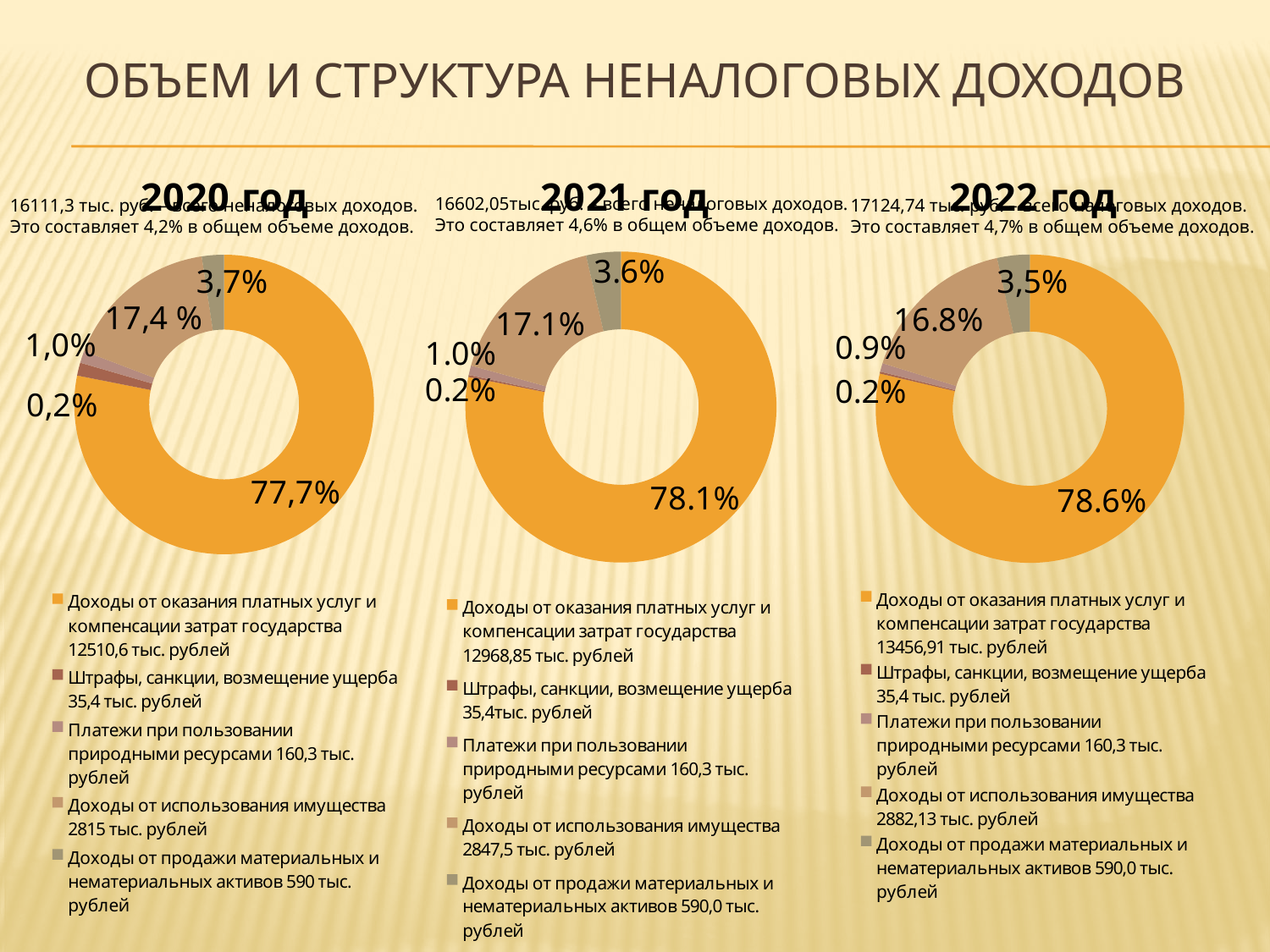
How many entries does the legend of the 2022 год chart list? 5 Which is larger: the share of Доходы от использования имущества in the 2020 год chart or in the 2022 год chart? 2020 год In the 2022 год chart, what percentage is shown for Доходы от продажи материальных и нематериальных активов? 3,5% How many slices does the 2021 год chart have? 5 In the 2020 год chart, which category has the largest share? Доходы от оказания платных услуг и компенсации затрат государства How many charts are shown on the slide? 3 In the 2020 год chart, what percentage is shown for the largest slice (Доходы от оказания платных услуг и компенсации затрат государства)? 77,7% What type of chart is used for the 2020 год data? Doughnut (pie) chart In the 2022 год chart, what percentage is shown for Штрафы, санкции, возмещение ущерба? 0.2% In the 2021 год chart, what percentage is shown for Доходы от использования имущества? 17.1% In the 2022 год chart, what is the difference between the 78.6% slice and the 16.8% slice? 61.8% In the 2021 год chart, which category has the smallest share? Штрафы, санкции, возмещение ущерба